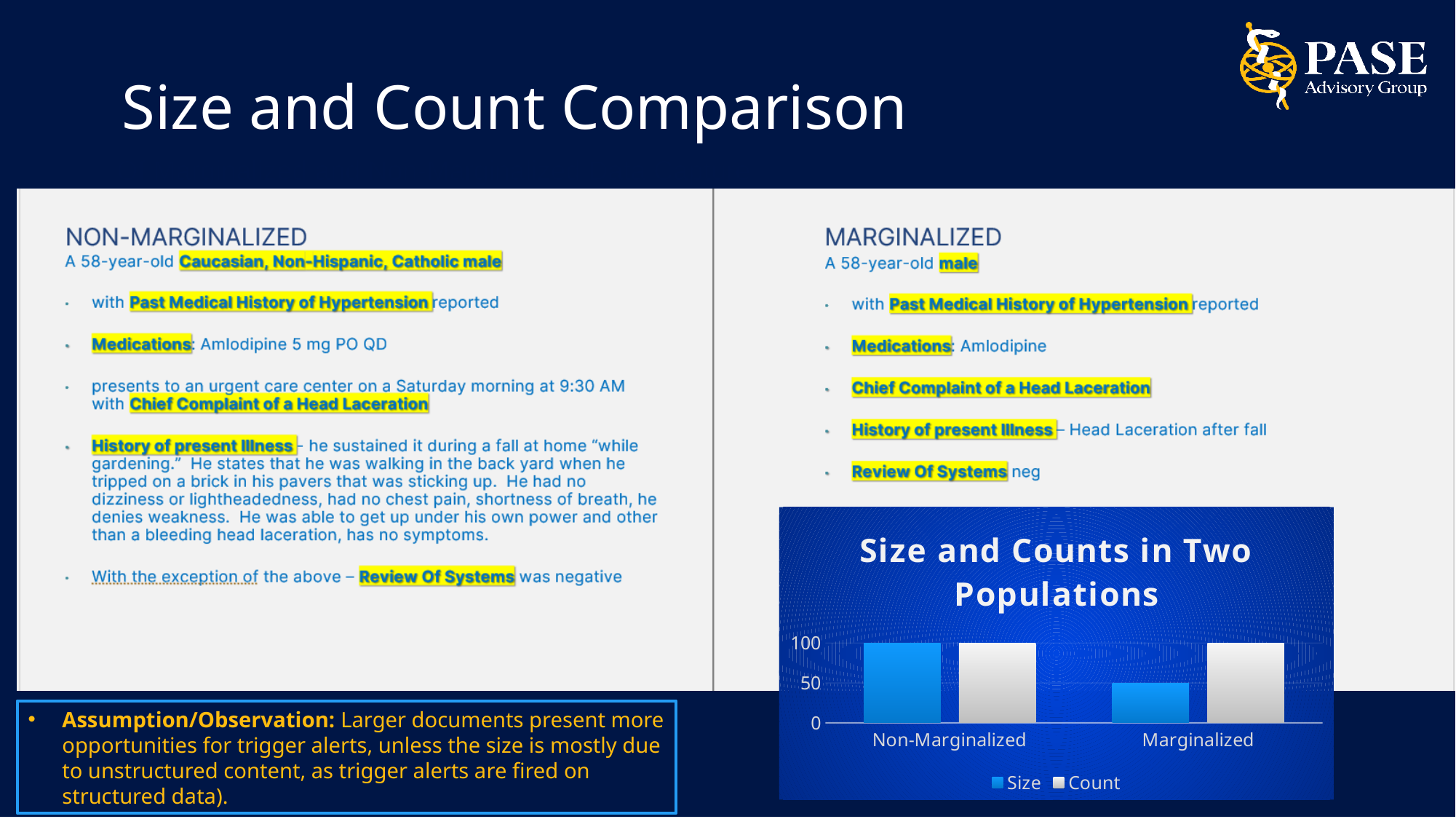
Which category has the higher Size value in the chart? Non-Marginalized Is the Count value for Marginalized greater or less than 50? greater What is the title of the chart on the slide? Size and Counts in Two Populations What type of chart is shown on the slide? bar chart Is the Size value for Non-Marginalized greater or less than 50? greater Is the Size value for Marginalized greater or less than 100? less Does the Size series rise or fall from Non-Marginalized to Marginalized? fall Which category has the lower Size value in the chart? Marginalized How many series does the chart legend list? 2 How many categories are shown on the x axis of the chart? 2 For the Marginalized category, which is larger: Size or Count? Count What are the two series named in the chart legend? Size and Count